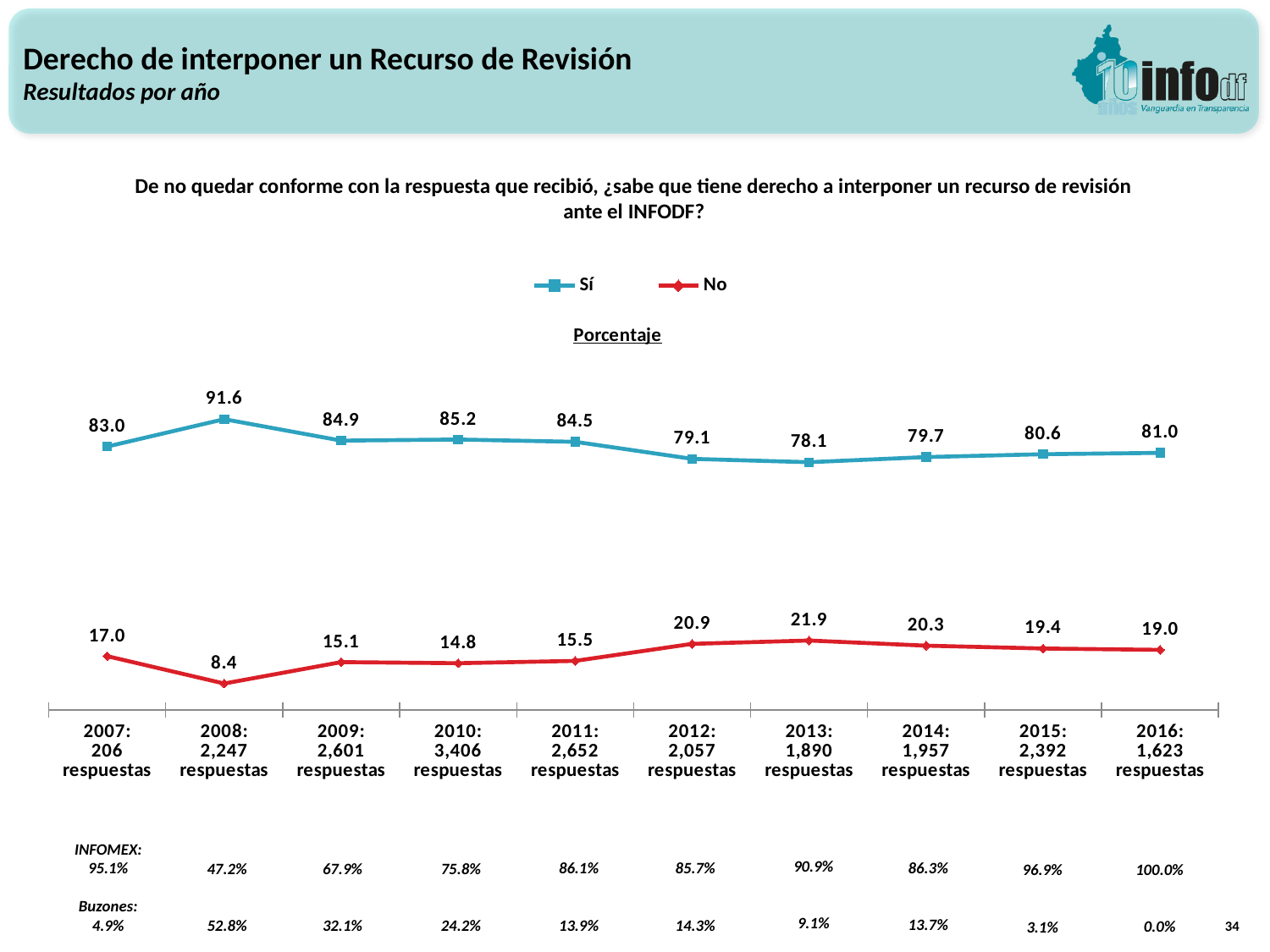
How many years are plotted on the x axis? 10 What is the difference between the Sí and No values in 2008? 83.2 In which year is the Sí series lowest? 2013 In which year is the Sí series highest? 2008 What is the value of the No series for 2013? 21.9 What is the value of the Sí series for 2008? 91.6 What is the value of the Sí series for 2016? 81.0 How many series does the legend list? 2 Does the No series rise or fall from 2013 to 2016? fall In which year is the No series lowest? 2008 Which is larger, the Sí value for 2010 or the Sí value for 2011? 2010 What kind of chart is shown on the slide? line chart